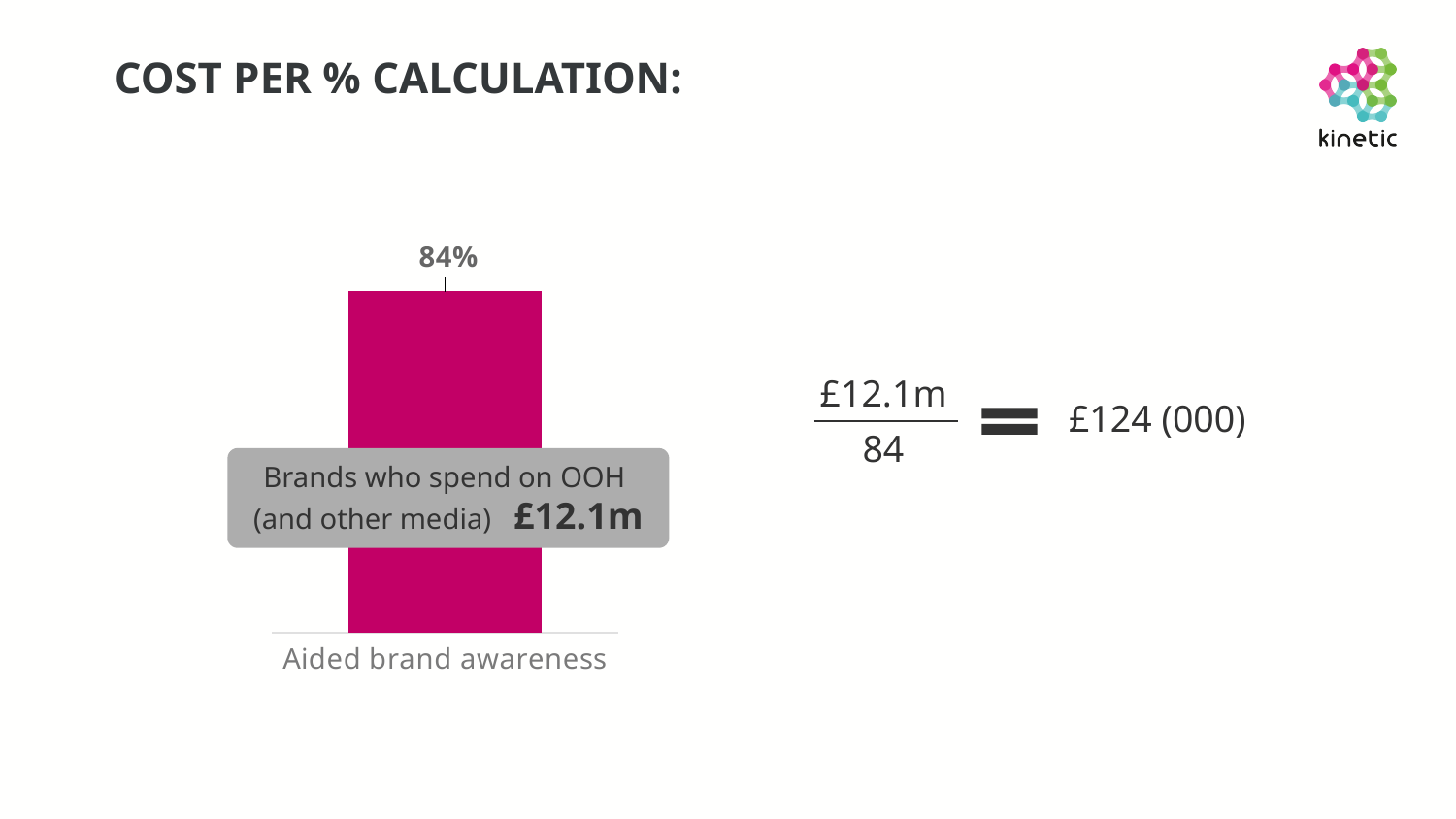
What colour is the bar in the chart? Magenta (pink) What kind of chart is shown on the slide? Bar chart How many bars does the chart show? 1 What is the value shown for Aided brand awareness in the bar chart? 84% What is the category label on the x axis of the chart? Aided brand awareness